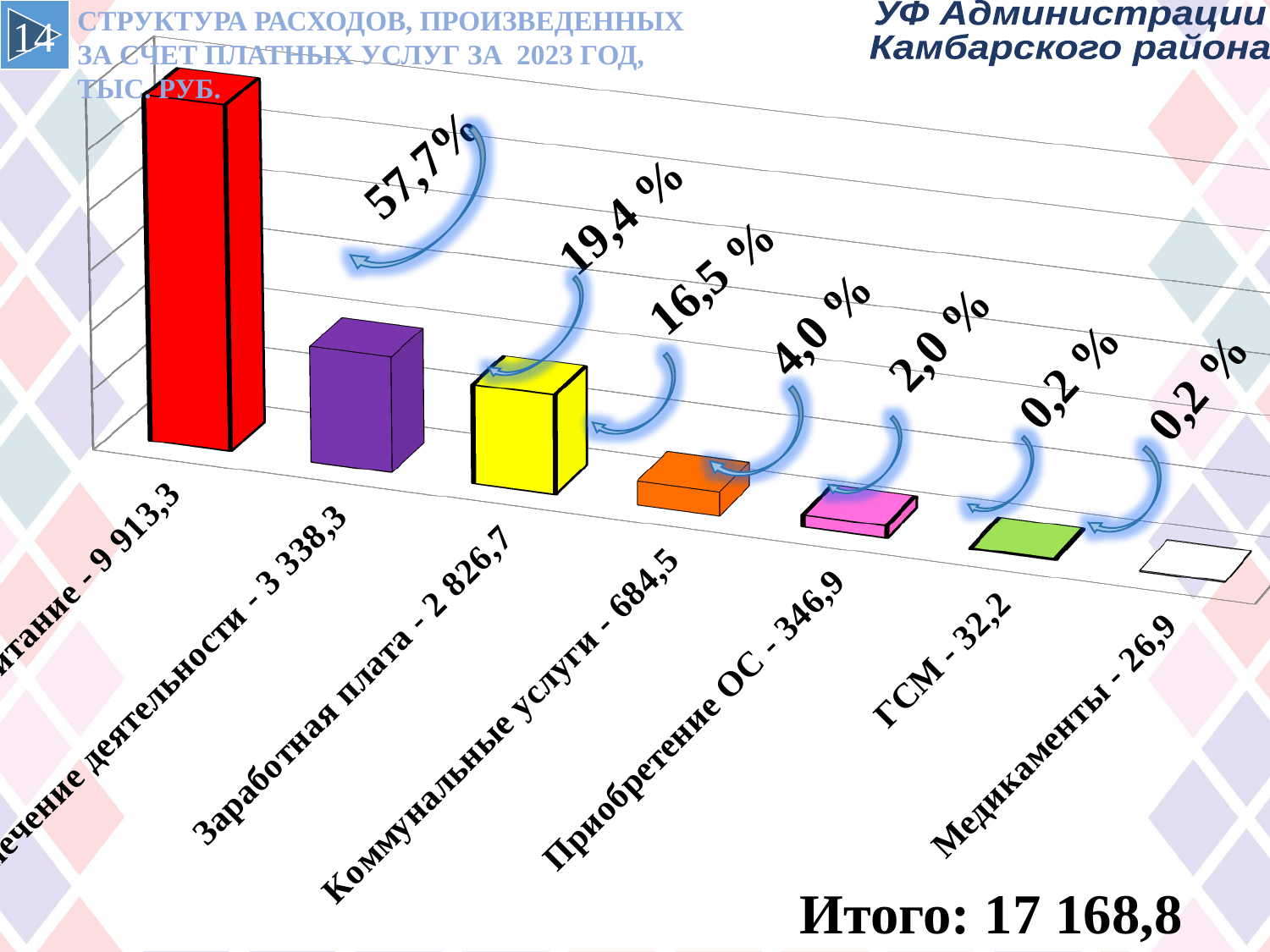
What kind of chart is shown on the slide? Bar chart What is the value for Приобретение ОС? 346,9 What is the value for Заработная плата? 2 826,7 What is the value for Коммунальные услуги? 684,5 How many categories (bars) are shown in the chart? 7 Which is larger, the value for Коммунальные услуги or for Приобретение ОС? Коммунальные услуги What is the difference between the values for ГСМ and Медикаменты? 5,3 Which category has the lowest value? Медикаменты What is the value for ГСМ? 32,2 Do the values rise or fall from left to right across the categories? Fall What is the value for Медикаменты? 26,9 What is the difference between the values for Заработная плата and Коммунальные услуги? 2 142,2